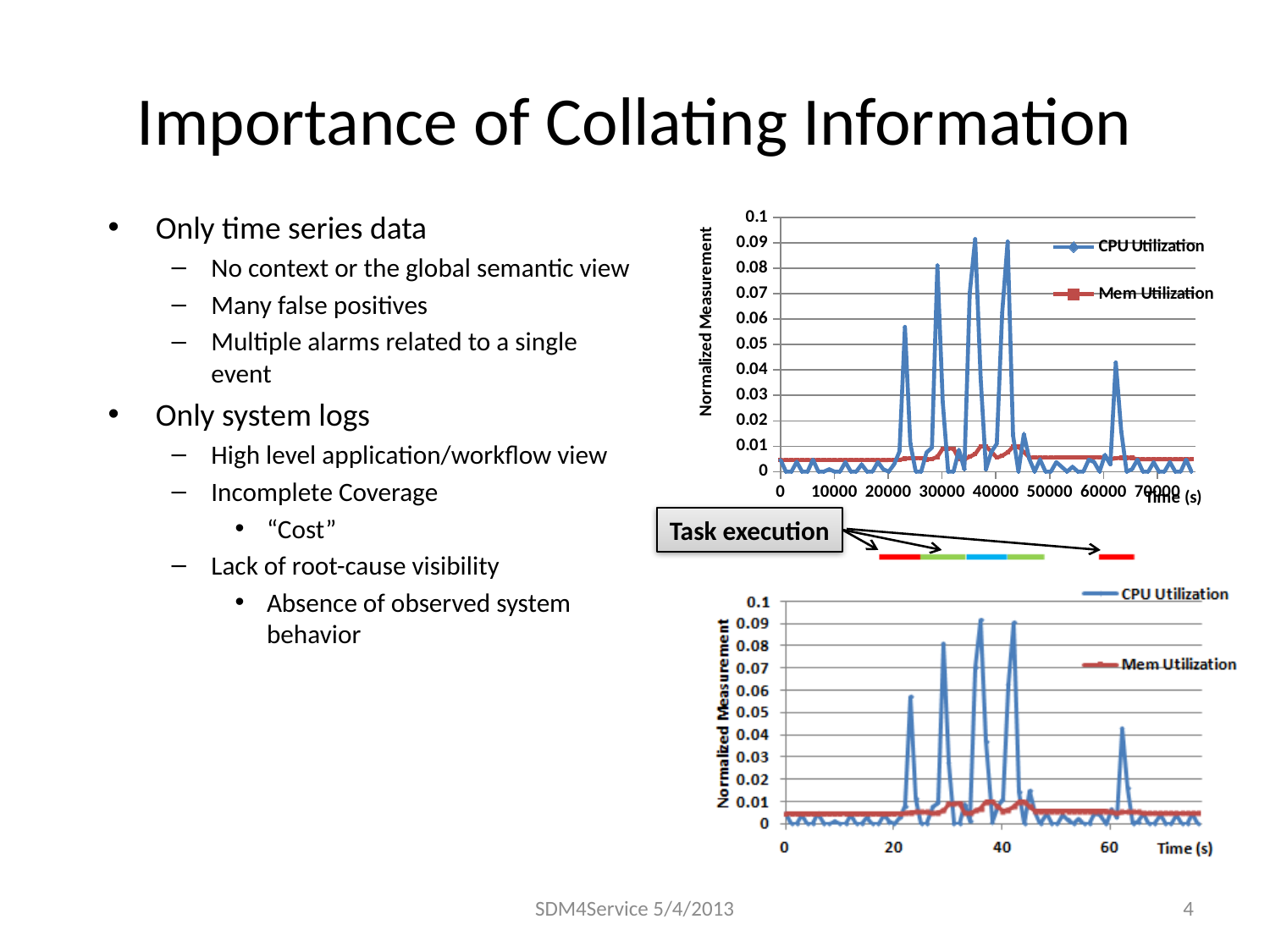
In the top chart, is the highest Mem Utilization value greater or less than 0.02? less How many series does the legend of the bottom chart list? 2 In the top chart, is the highest CPU Utilization value greater or less than 0.08? greater What kind of chart is the bottom chart on the slide? line chart What are the two series named in the legend of the top chart? CPU Utilization and Mem Utilization How many series does the legend of the top chart list? 2 In the bottom chart, is the CPU Utilization peak near 23 on the x axis greater or less than 0.05? greater What is the y-axis label of the top chart? Normalized Measurement In the top chart, which series reaches the higher peak value, CPU Utilization or Mem Utilization? CPU Utilization What kind of chart is the top chart on the slide? line chart